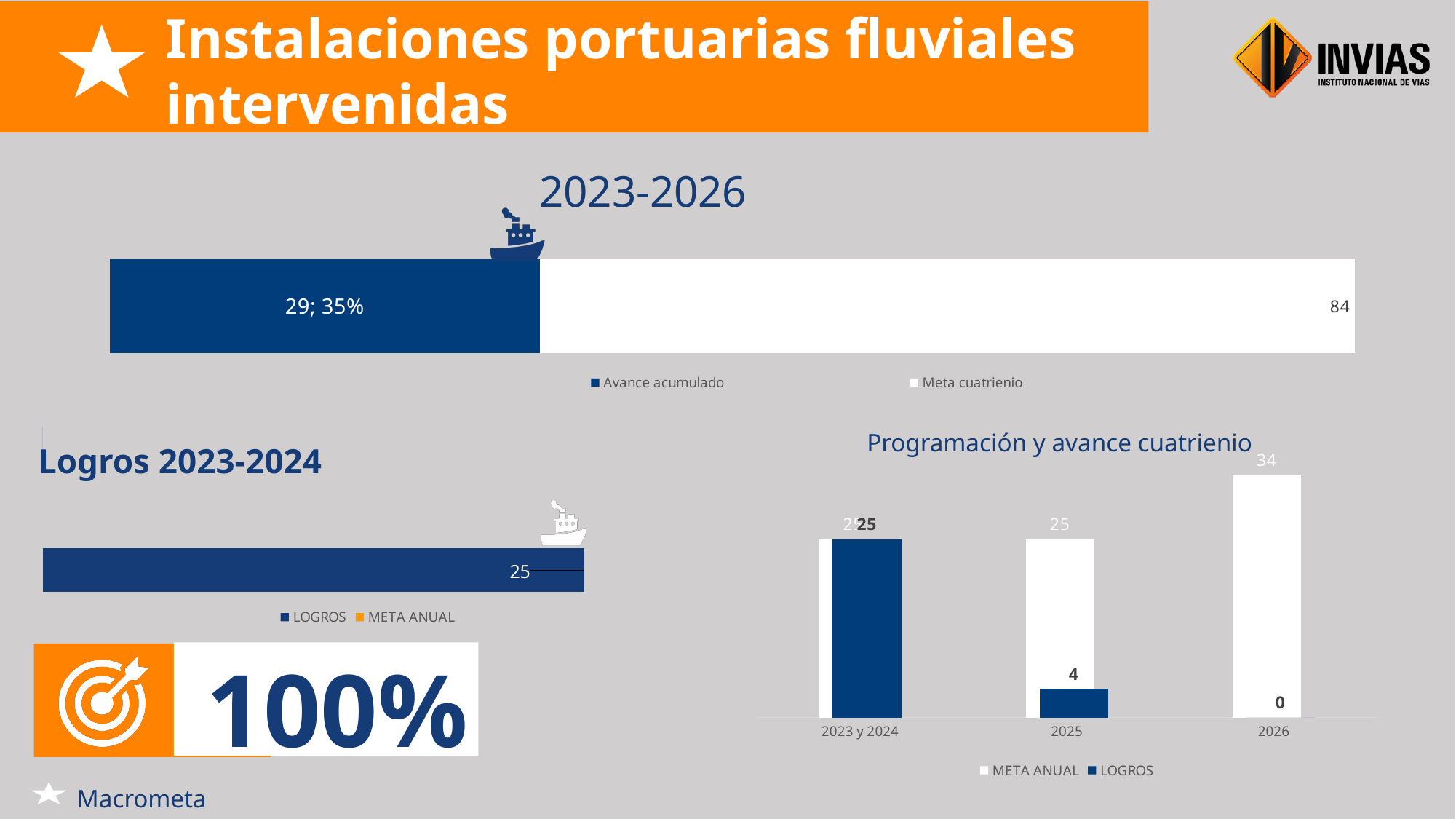
In the '2023-2026' chart, what is the value of Meta cuatrienio? 84 In the '2023-2026' chart, how many series does the legend list? 2 In the '2023-2026' chart, what is the value of Avance acumulado? 29; 35% In the '2023-2026' chart, which series is larger, Avance acumulado or Meta cuatrienio? Meta cuatrienio In the 'Programación y avance cuatrienio' chart, which category has the highest META ANUAL value? 2026 In the 'Programación y avance cuatrienio' chart, how many categories are shown on the x axis? 3 In the 'Programación y avance cuatrienio' chart, what is the META ANUAL value for 2026? 34 In the 'Programación y avance cuatrienio' chart, what is the LOGROS value for 2025? 4 In the 'Programación y avance cuatrienio' chart, what is the difference between META ANUAL and LOGROS for 2025? 21 In the 'Programación y avance cuatrienio' chart, what is the LOGROS value for 2026? 0 What kind of chart is 'Programación y avance cuatrienio'? Bar chart In the 'Logros 2023-2024' chart, what value is shown for LOGROS? 25